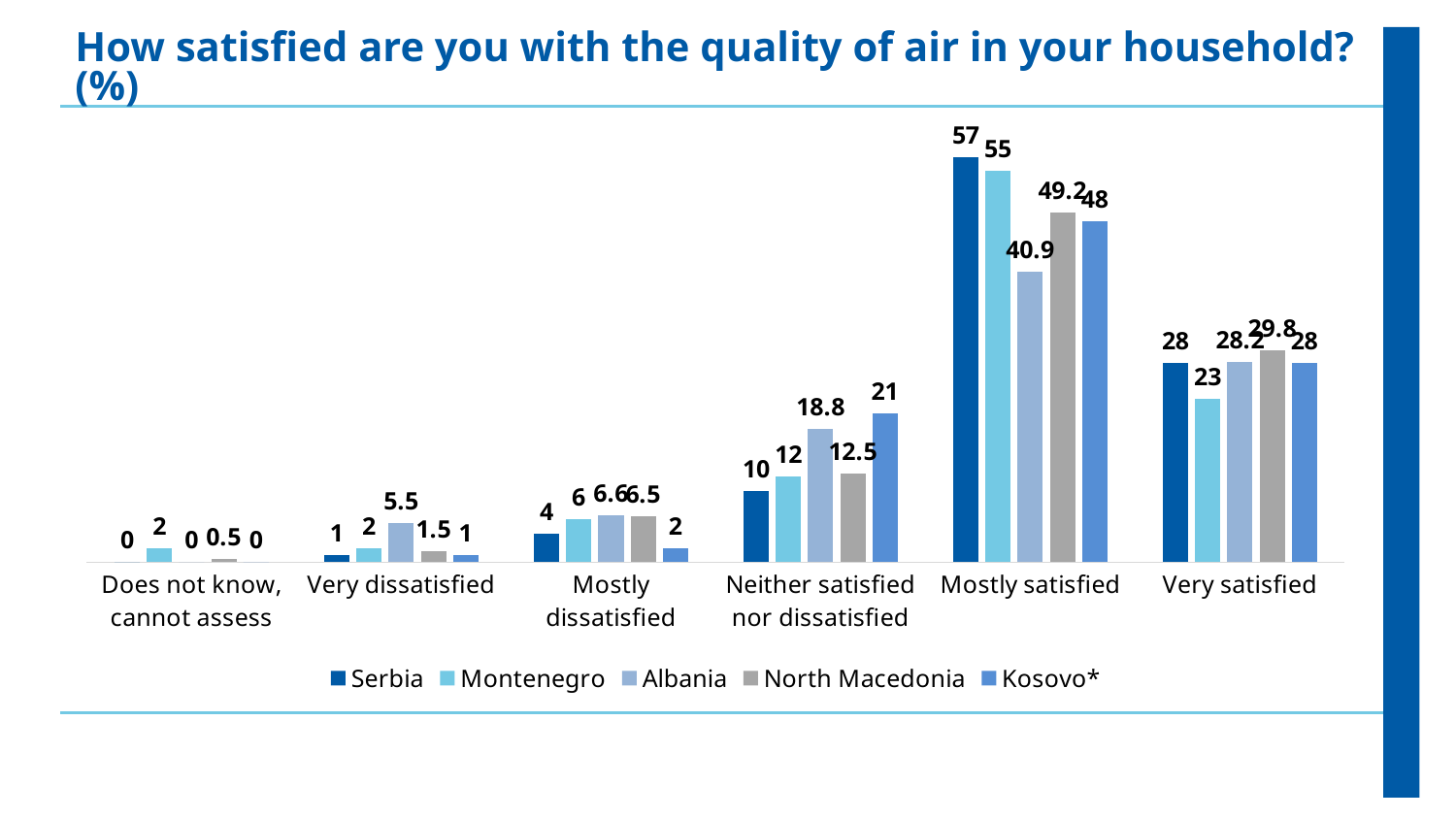
Which is larger in the Very dissatisfied category, Albania or North Macedonia? Albania Which country is listed last in the legend? Kosovo* Which country has the highest value in the Mostly satisfied category? Serbia How many countries does the legend list? 5 What is the value for Albania in the Neither satisfied nor dissatisfied category? 18.8 What is the value for Kosovo* in the Neither satisfied nor dissatisfied category? 21 What is the difference between Serbia and Albania in the Mostly satisfied category? 16.1 What kind of chart is shown on the slide? Bar chart What is the value for Serbia in the Mostly satisfied category? 57 What is the value for Montenegro in the Very satisfied category? 23 Which country has the lowest value in the Mostly satisfied category? Albania How many response categories are shown on the x axis? 6